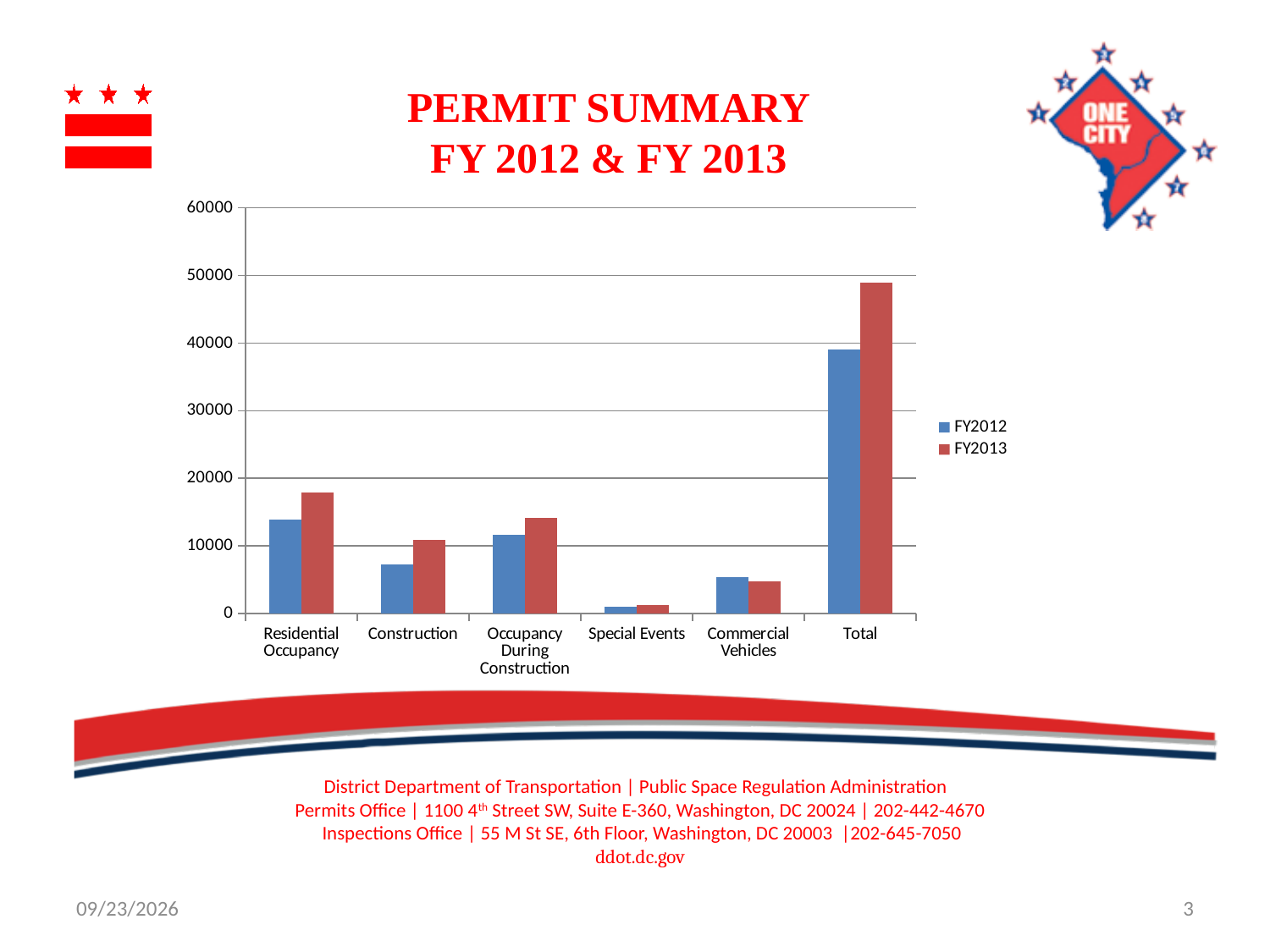
For Commercial Vehicles, which series has the larger value, FY2012 or FY2013? FY2012 How many categories are shown on the x axis of the chart? 6 Is the FY2012 value for Total greater or less than 40000? less Is the FY2012 value for Construction greater or less than 10000? less Is the FY2013 value for Total greater or less than 40000? greater For Residential Occupancy, which series has the larger value, FY2012 or FY2013? FY2013 Which category has the lowest FY2012 value? Special Events Which category has the highest FY2013 value? Total What kind of chart is shown on the slide? bar chart How many series does the legend list? 2 Excluding Total, which category has the highest FY2013 value? Residential Occupancy What is the title of the chart on the slide? PERMIT SUMMARY FY 2012 & FY 2013